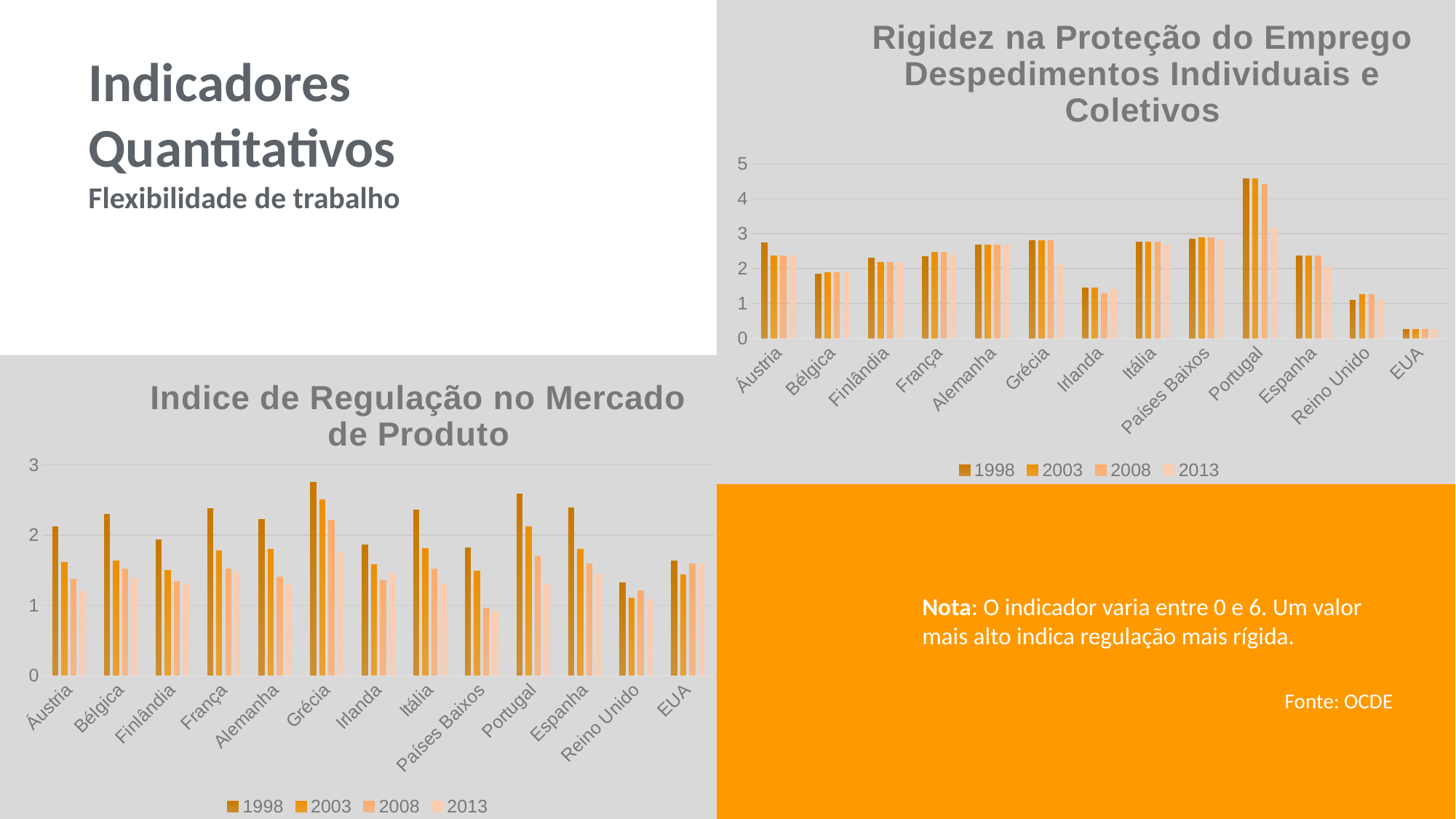
In the chart titled "Indice de Regulação no Mercado de Produto", how many series does the legend list? 4 What type of chart is the chart titled "Indice de Regulação no Mercado de Produto"? bar chart In the chart titled "Rigidez na Proteção do Emprego Despedimentos Individuais e Coletivos", which country has the highest value for 1998? Portugal In the chart titled "Indice de Regulação no Mercado de Produto", which country has the lowest value for 1998? Reino Unido In the chart titled "Rigidez na Proteção do Emprego Despedimentos Individuais e Coletivos", which country has the lowest value for 1998? EUA In the chart titled "Indice de Regulação no Mercado de Produto", which country has the highest value for 1998? Grécia In the chart titled "Indice de Regulação no Mercado de Produto", which is larger for 1998: Portugal or Irlanda? Portugal In the chart titled "Indice de Regulação no Mercado de Produto", is the 1998 value for Grécia greater or less than 2? greater In the chart titled "Rigidez na Proteção do Emprego Despedimentos Individuais e Coletivos", do the values for Portugal rise or fall from 1998 to 2013? fall In the chart titled "Rigidez na Proteção do Emprego Despedimentos Individuais e Coletivos", is the 1998 value for Irlanda greater or less than 2? less In the chart titled "Rigidez na Proteção do Emprego Despedimentos Individuais e Coletivos", how many countries are shown on the x axis? 13 In the chart titled "Rigidez na Proteção do Emprego Despedimentos Individuais e Coletivos", is the 1998 value for Portugal greater or less than 4? greater